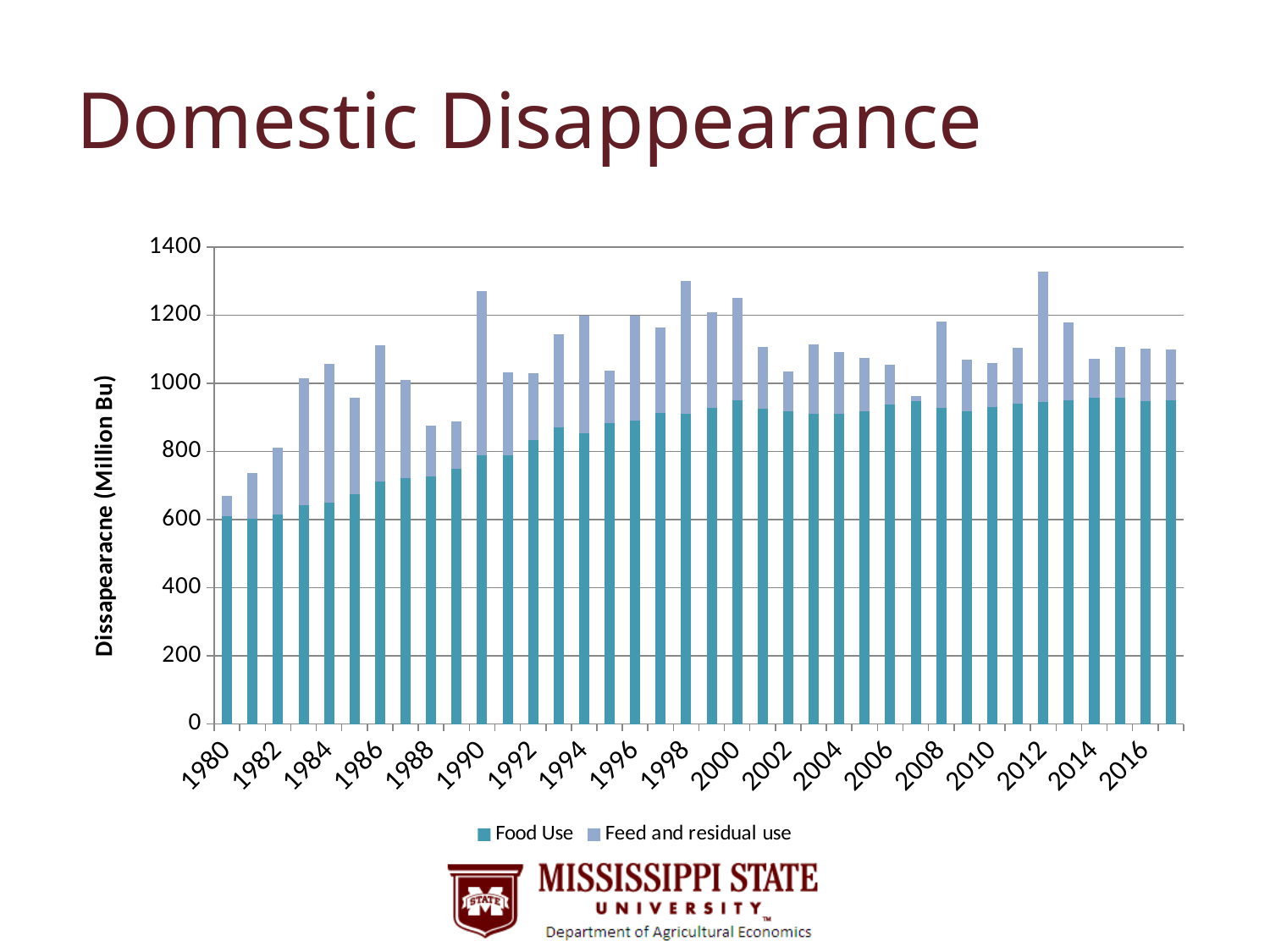
Is the total domestic disappearance for 1980 greater or less than 800? less Which year has the lowest total domestic disappearance? 1980 Is the Food Use value for 2016 greater or less than 800? greater Which year has the highest total domestic disappearance? 2012 Does the Food Use series generally rise or fall from 1980 to 2016? rise What are the two series named in the legend? Food Use; Feed and residual use Which is larger, the total domestic disappearance in 1980 or in 2012? 2012 What is the title of the chart on the slide? Domestic Disappearance Is the total domestic disappearance for 2012 greater or less than 1200? greater What kind of chart is shown on the slide? Stacked bar chart How many series does the legend list? 2